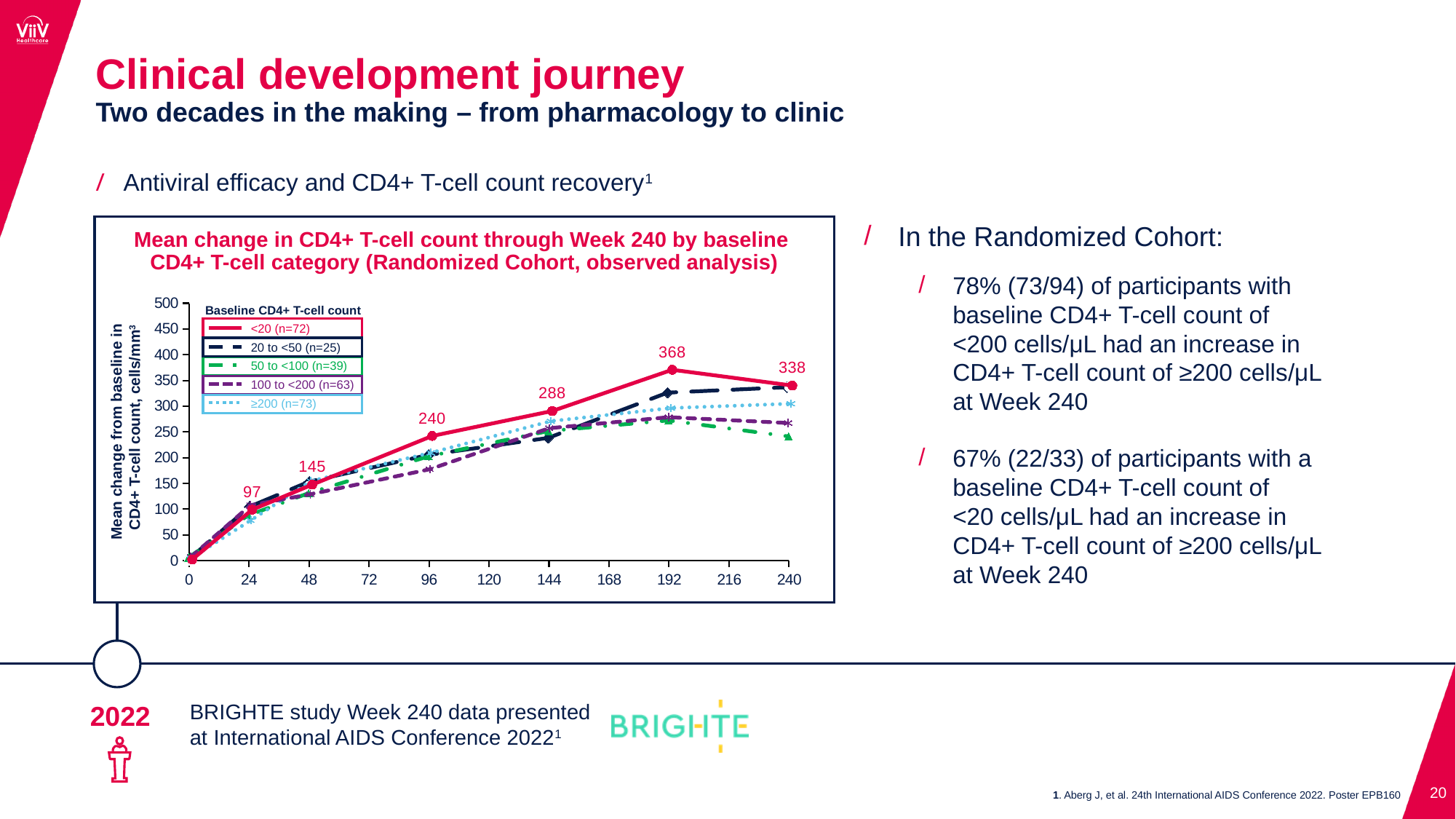
Is the Week 240 value for the 50 to <100 (n=39) baseline group greater or less than 300? less What is the mean change in CD4+ T-cell count at Week 96 for the <20 (n=72) baseline group? 240 What is the difference between the Week 192 and Week 240 values for the <20 (n=72) baseline group? 30 Does the <20 (n=72) baseline group's mean change in CD4+ T-cell count rise or fall between Week 0 and Week 192? Rise What is the mean change in CD4+ T-cell count at Week 192 for the <20 (n=72) baseline group? 368 How many series does the legend list? 5 What kind of chart is shown on the slide? Line chart What is the mean change in CD4+ T-cell count at Week 240 for the <20 (n=72) baseline group? 338 At which week does the <20 (n=72) baseline group reach its highest labelled mean change in CD4+ T-cell count? Week 192 What is the mean change in CD4+ T-cell count at Week 24 for the <20 (n=72) baseline group? 97 For the <20 (n=72) baseline group, which is larger: the value at Week 96 or the value at Week 144? Week 144 What is the difference between the Week 144 and Week 48 values for the <20 (n=72) baseline group? 143